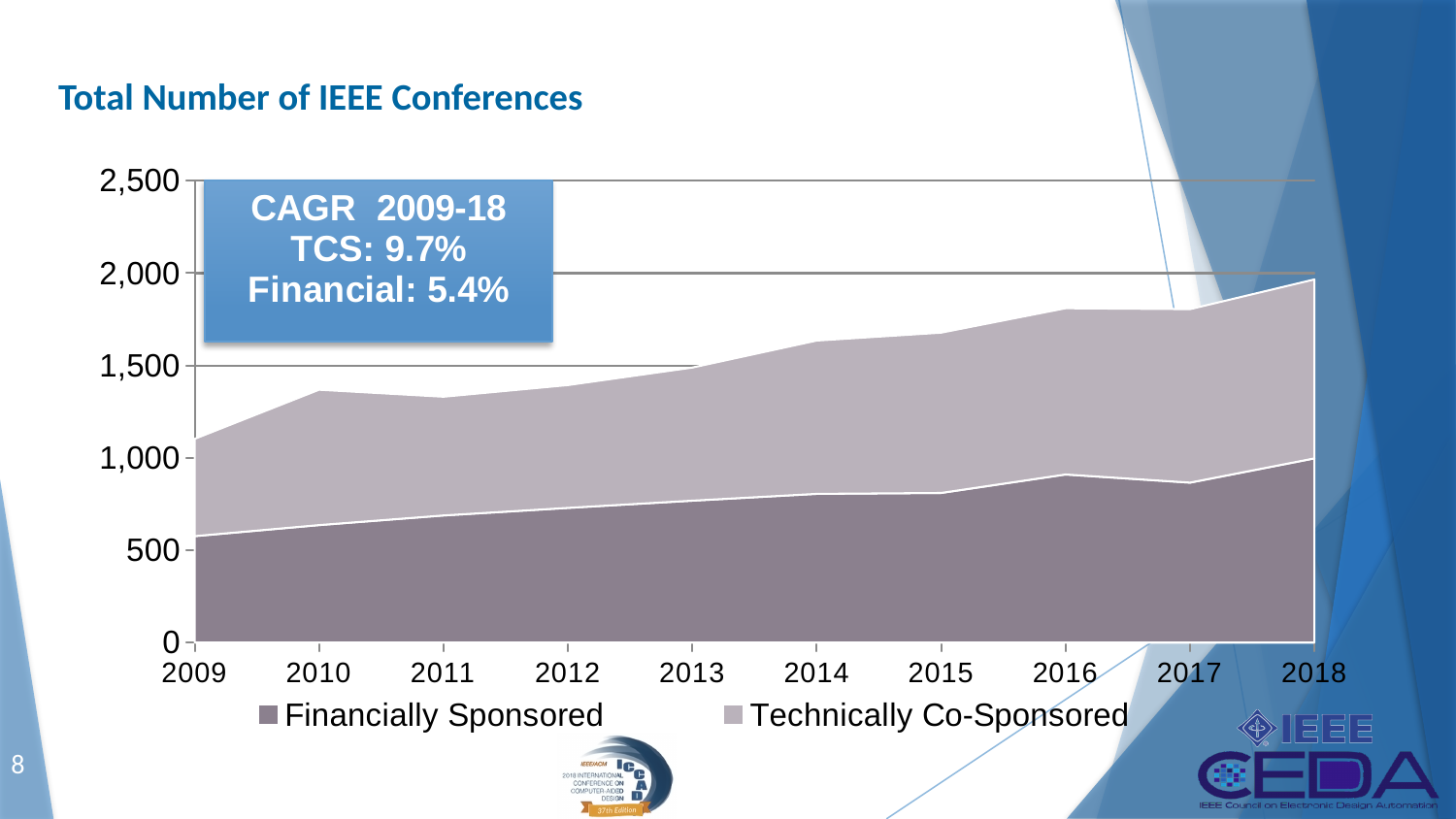
What CAGR for 2009-18 is given for TCS in the text box on the chart? 9.7% How many years are shown on the x axis? 10 What type of chart is shown on the slide? Stacked area chart How many series does the legend list? 2 Does the total number of conferences generally rise or fall from 2009 to 2018? Rise In which year is the Financially Sponsored value lowest? 2009 Is the total number of conferences in 2009 greater or less than 1,000? greater Is the total number of conferences in 2014 greater or less than 1,500? greater What is the title of the chart? Total Number of IEEE Conferences Is the Financially Sponsored value for 2009 greater or less than 500? greater In which year is the total number of conferences highest? 2018